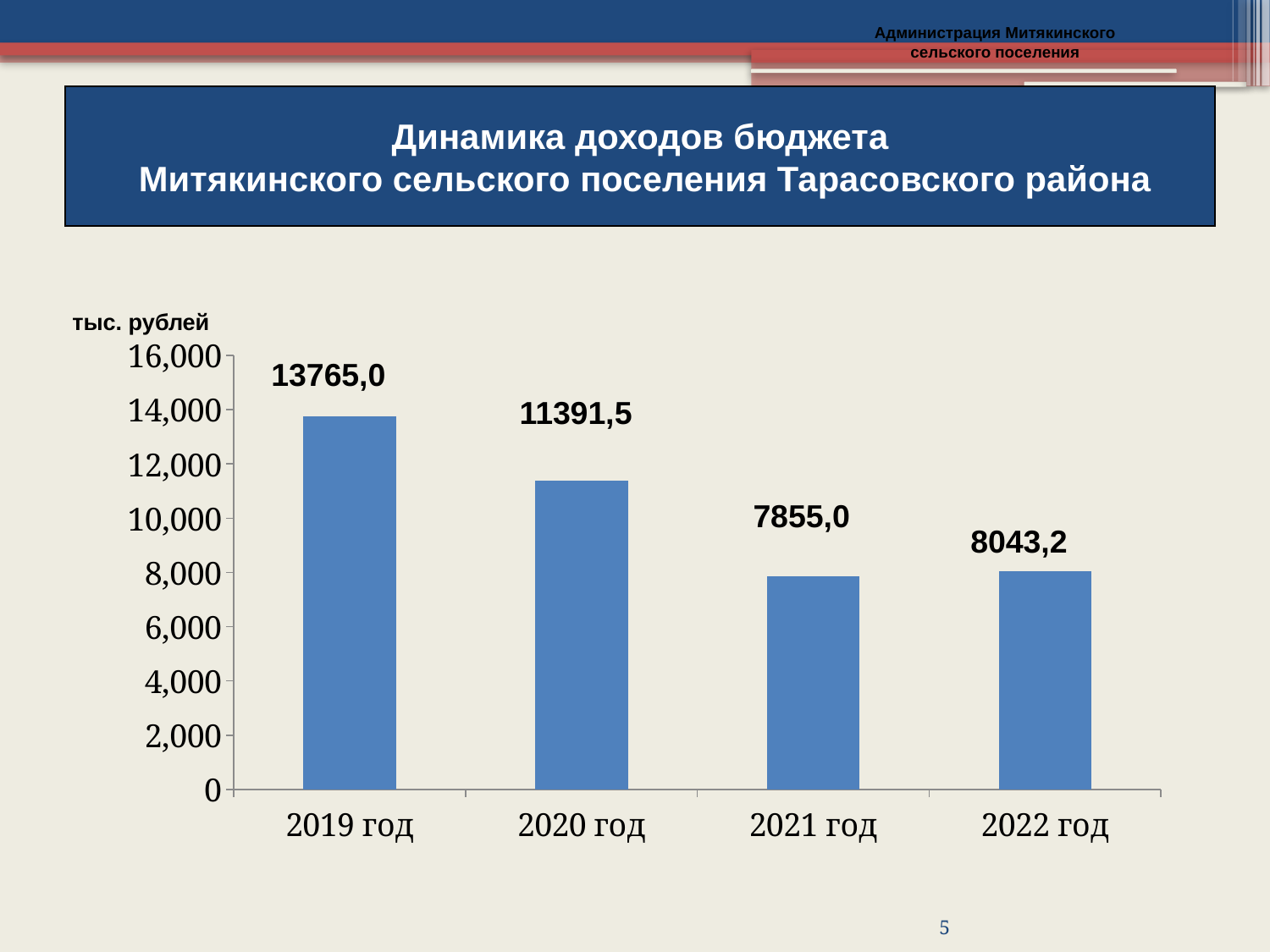
What is the value for 2022 год? 8043,2 What is the difference between the values for 2019 год and 2020 год? 2373,5 Which year has the lowest value? 2021 год What is the value for 2021 год? 7855,0 What kind of chart is shown on the slide? bar chart Is the value for 2020 год greater or less than 12,000? less How many years are shown on the chart? 4 Which is larger, the value for 2020 год or the value for 2022 год? 2020 год Which year has the highest value? 2019 год What is the difference between the values for 2022 год and 2021 год? 188,2 What unit is indicated above the vertical axis? тыс. рублей What is the value for 2019 год? 13765,0